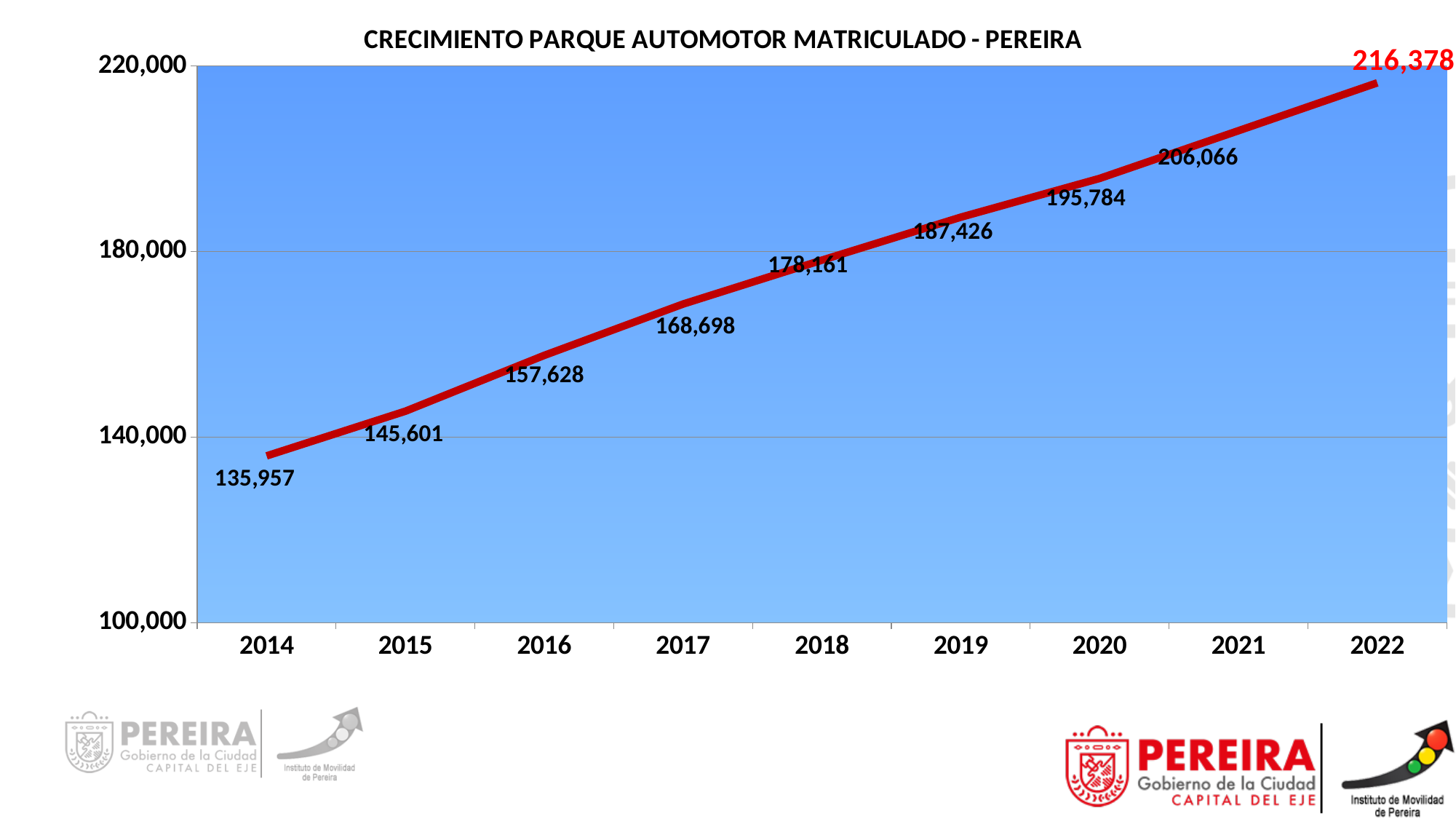
What is the difference between the values for 2022 and 2014? 80,421 Do the values rise or fall from 2014 to 2022? rise What kind of chart is shown? line chart Is the value for 2019 greater or less than 180,000? greater How many years are plotted on the chart? 9 Which year has the highest value? 2022 Which year has the lowest value? 2014 What is the value for 2014? 135,957 What is the difference between the values for 2020 and 2019? 8,358 What is the value for 2018? 178,161 What is the value for 2022? 216,378 Which is larger, the value for 2016 or the value for 2017? 2017